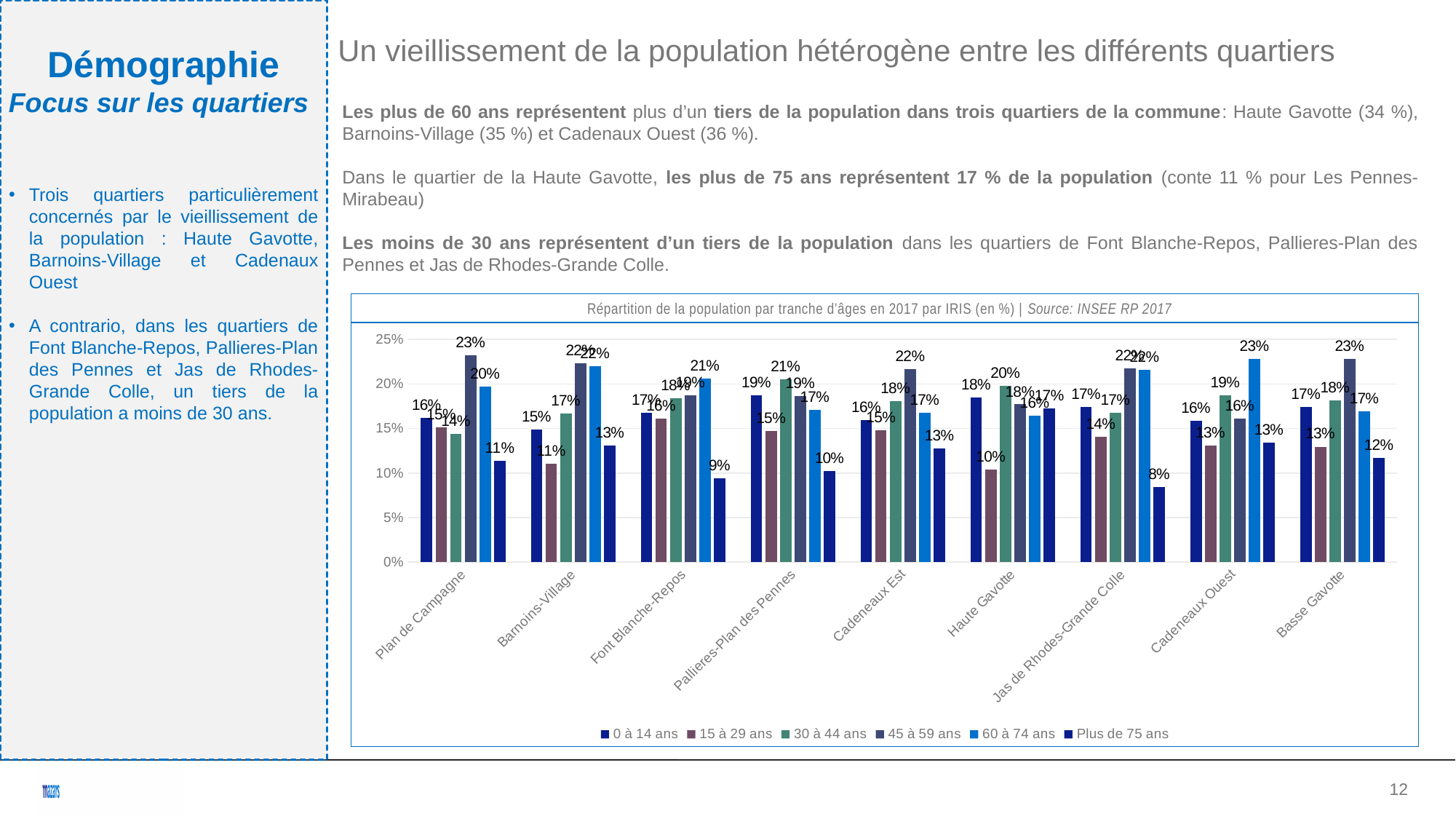
What type of chart is shown on the slide? Bar chart Which quartier has the lowest value for 'Plus de 75 ans'? Jas de Rhodes-Grande Colle What is the value for 'Plus de 75 ans' in Haute Gavotte? 17% What is the value for '60 à 74 ans' in Cadeneaux Ouest? 23% Which quartier has the highest value for 'Plus de 75 ans'? Haute Gavotte Which is larger in Font Blanche-Repos: the '60 à 74 ans' value or the 'Plus de 75 ans' value? 60 à 74 ans What is the value for '15 à 29 ans' in Barnoins-Village? 11% How many quartiers (categories) are shown on the x axis? 9 What is the difference between the '45 à 59 ans' value and the '30 à 44 ans' value in Plan de Campagne? 9% What source is cited in the chart title? INSEE RP 2017 How many series does the legend list? 6 Which quartier has the lowest value for '15 à 29 ans'? Haute Gavotte